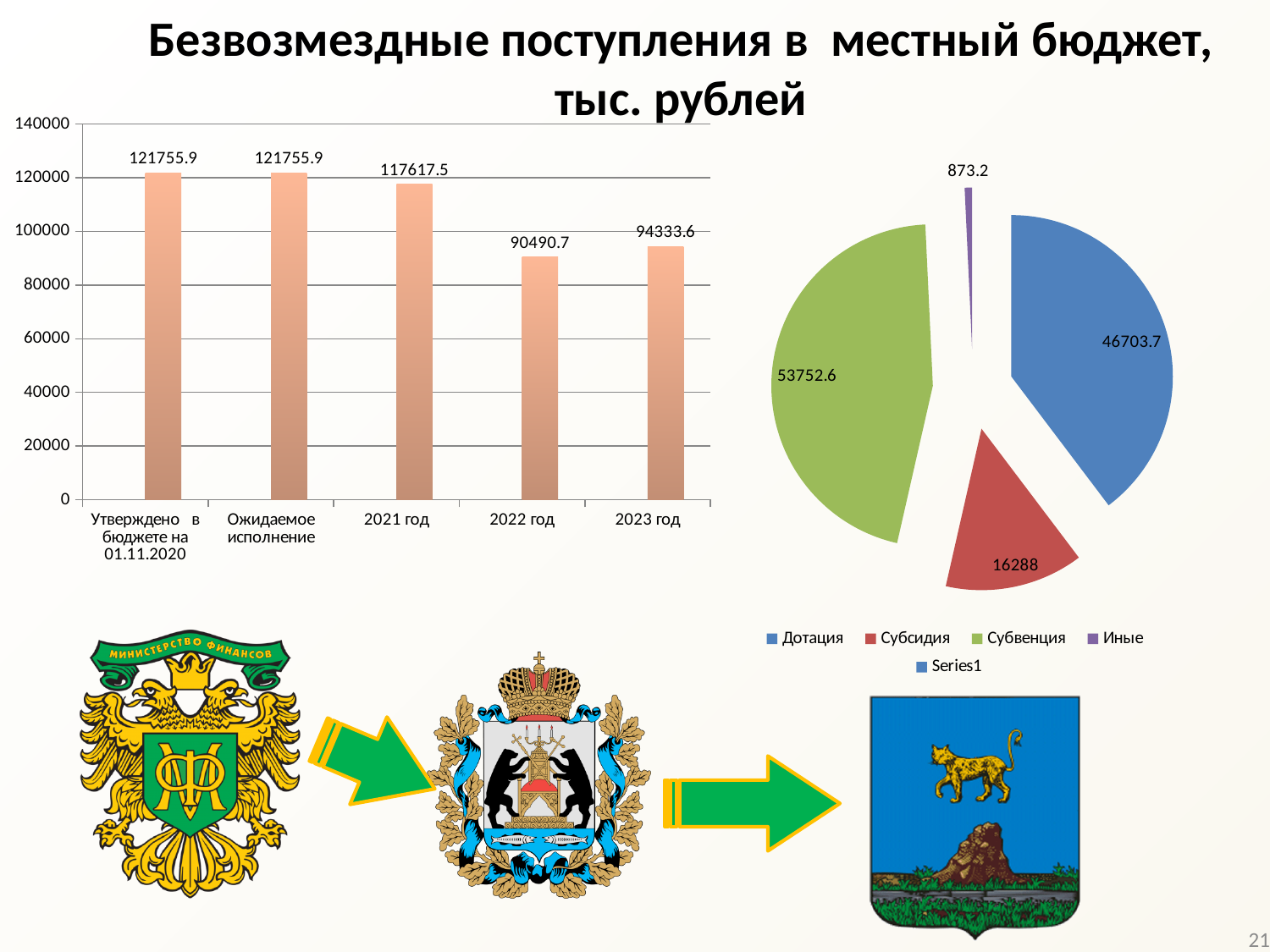
On the bar chart on the left, what is the value for Ожидаемое исполнение? 121755.9 On the pie chart on the right, which colour is used for the Иные slice? purple On the pie chart on the right, what is the value for Субсидия? 16288 On the bar chart on the left, is the value for 2023 год greater or less than 100000? less What kind of chart is the chart on the left of the slide? bar chart On the bar chart on the left, which category has the lowest value? 2022 год On the bar chart on the left, what is the difference between the values for 2023 год and 2022 год? 3842.9 On the bar chart on the left, what is the value for 2021 год? 117617.5 On the pie chart on the right, what is the difference between the values for Субвенция and Дотация? 7048.9 On the pie chart on the right, which category has the largest slice? Субвенция On the bar chart on the left, what is the value for 2022 год? 90490.7 On the bar chart on the left, how many bars are plotted? 5